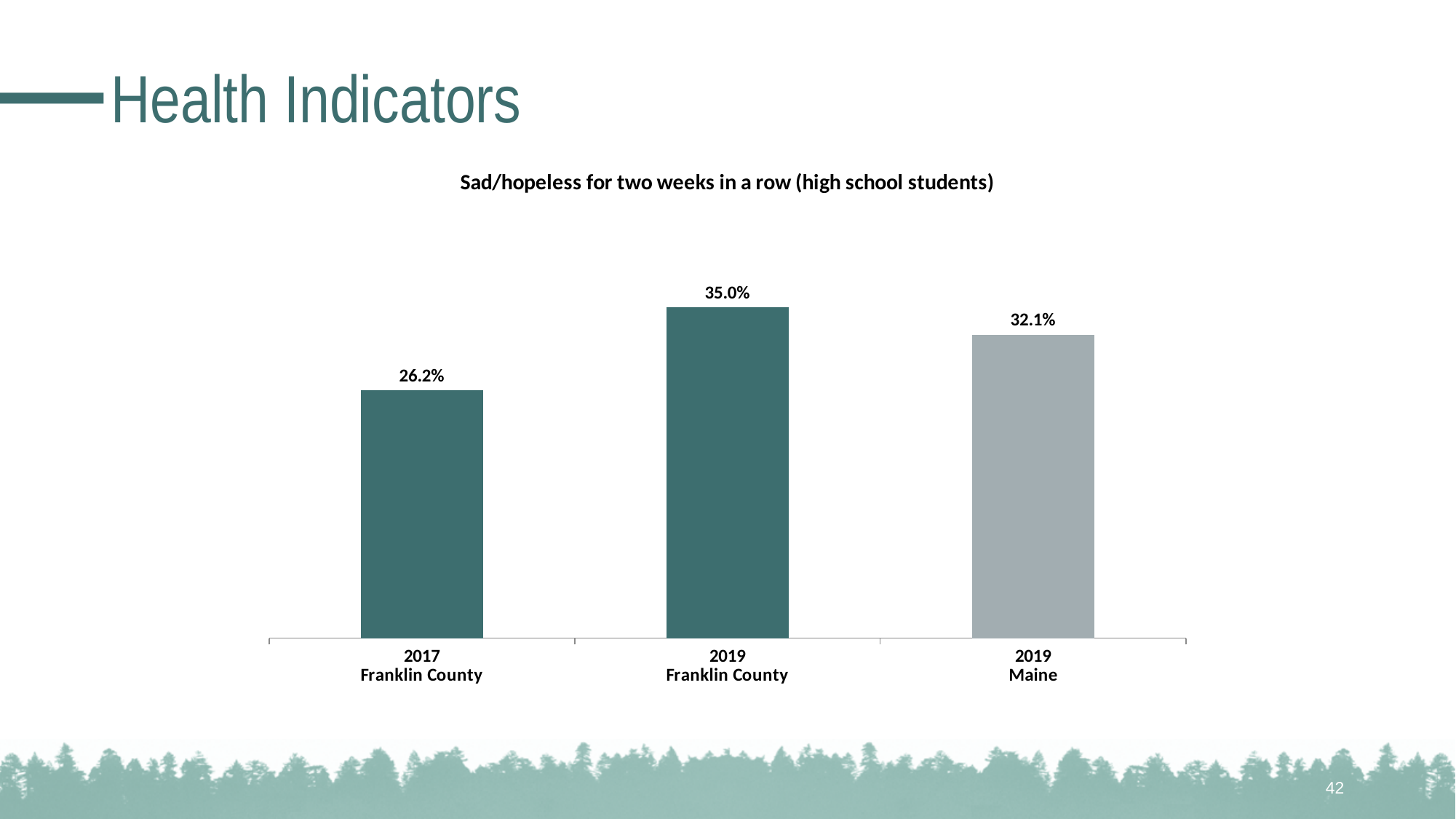
Which is larger, the value for 2019 Franklin County or the value for 2019 Maine? 2019 Franklin County What is the value for 2019 Franklin County? 35.0% What kind of chart is shown on the slide? Bar chart What is the difference between the 2019 Franklin County value and the 2019 Maine value? 2.9% What is the value for 2017 Franklin County? 26.2% What is the value for 2019 Maine? 32.1% Which category has the lowest value? 2017 Franklin County What is the difference between the 2019 Franklin County value and the 2017 Franklin County value? 8.8% Did the Franklin County value rise or fall from 2017 to 2019? Rise How many bars are shown in the chart? 3 What is the title of the chart? Sad/hopeless for two weeks in a row (high school students) Which category has the highest value? 2019 Franklin County